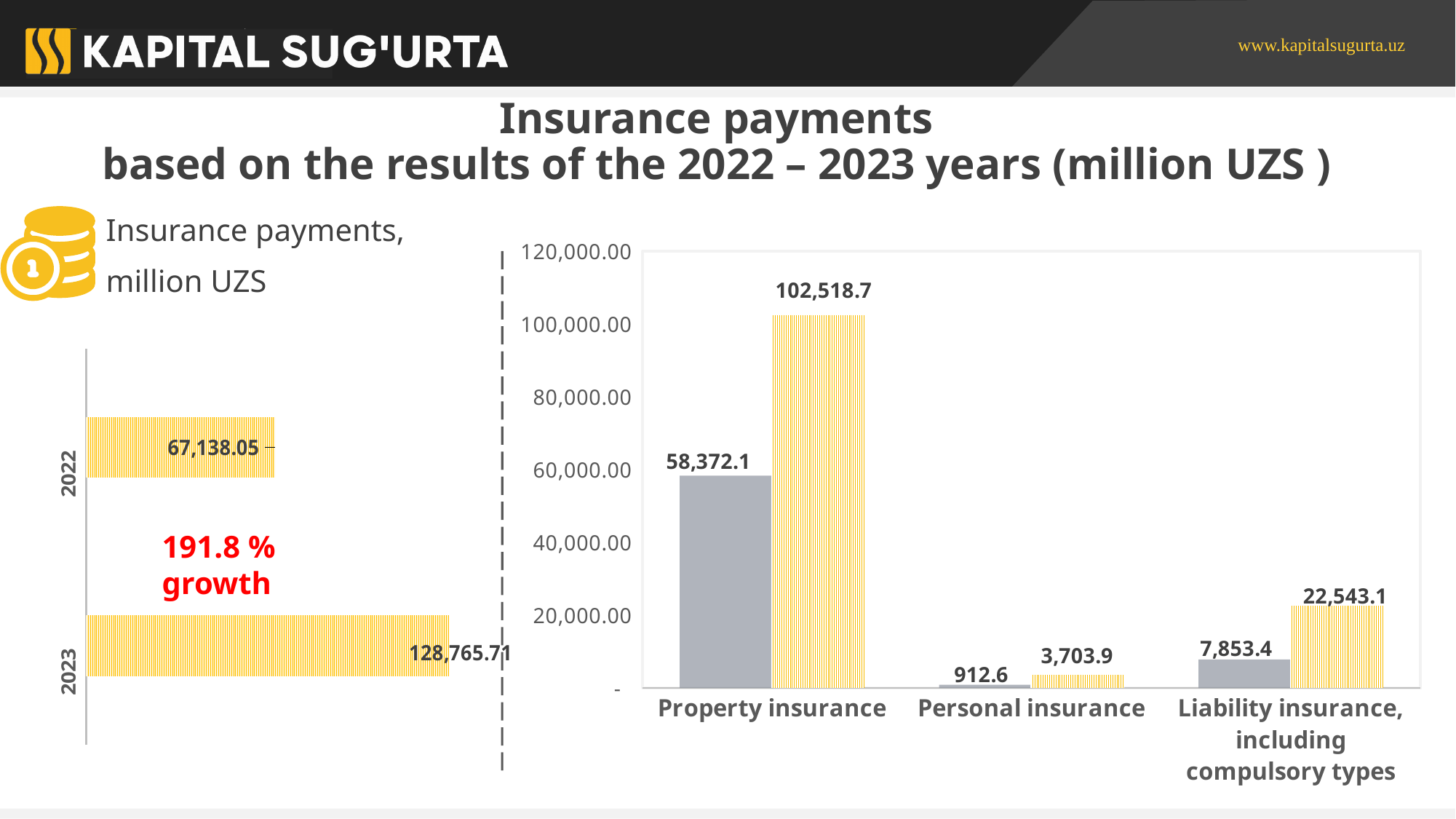
What type of chart is the left chart? bar chart In the right chart, which category has the highest value? Property insurance In the right chart, what is the value of the grey bar for Personal insurance? 912.6 How many categories are shown on the x axis of the right chart? 3 In the right chart, what is the value of the yellow bar for Property insurance? 102,518.7 What growth percentage is printed on the left chart? 191.8 % In the left chart, what is the value for 2023? 128,765.71 In the left chart, what is the difference between the 2023 and 2022 values? 61,627.66 In the right chart, what is the value of the yellow bar for Liability insurance, including compulsory types? 22,543.1 In the right chart, what is the difference between the yellow and grey bars for Property insurance? 44,146.6 In the left chart, what is the value for 2022? 67,138.05 In the right chart, which category has the lowest value? Personal insurance